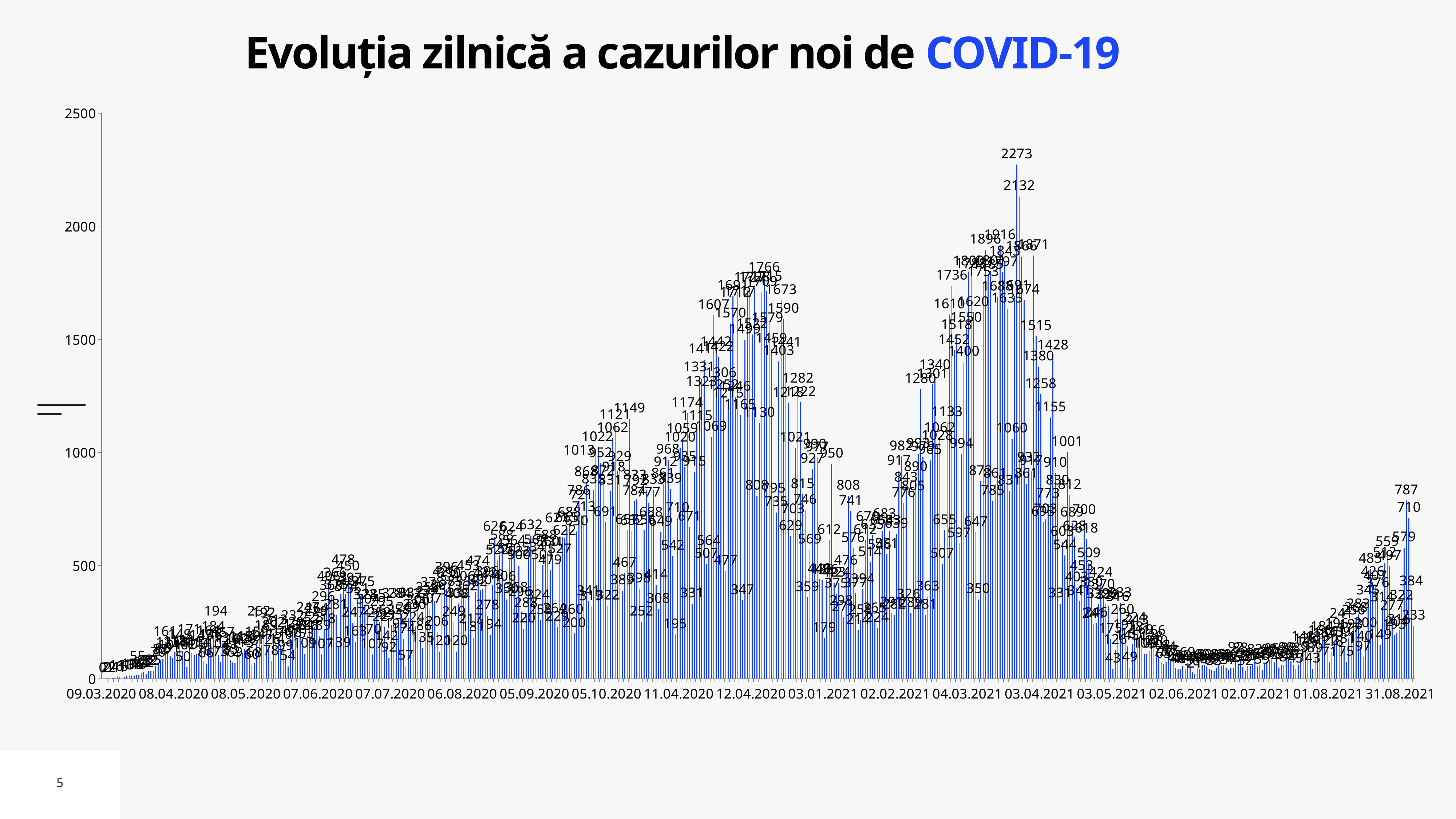
What is the maximum value shown on the vertical axis? 2500 Is the highest bar on the chart greater or less than 2000? greater Which is larger: the peak labelled 2273 or the peak labelled 1766? 2273 What is the title of the chart? Evoluția zilnică a cazurilor noi de COVID-19 Do the values rise or fall between 03.04.2021 and 02.06.2021? fall Is the value around 02.06.2021 greater or less than 500? less What is the difference between the two highest labelled values, 2273 and 2132? 141 Do the values rise or fall between 02.06.2021 and 31.08.2021? rise What is the second-highest daily value labelled on the chart, just below the 2273 peak? 2132 What kind of chart is shown on the slide? bar chart What is the highest daily value labelled on the chart? 2273 Is the value for the first date, 09.03.2020, greater or less than 500? less